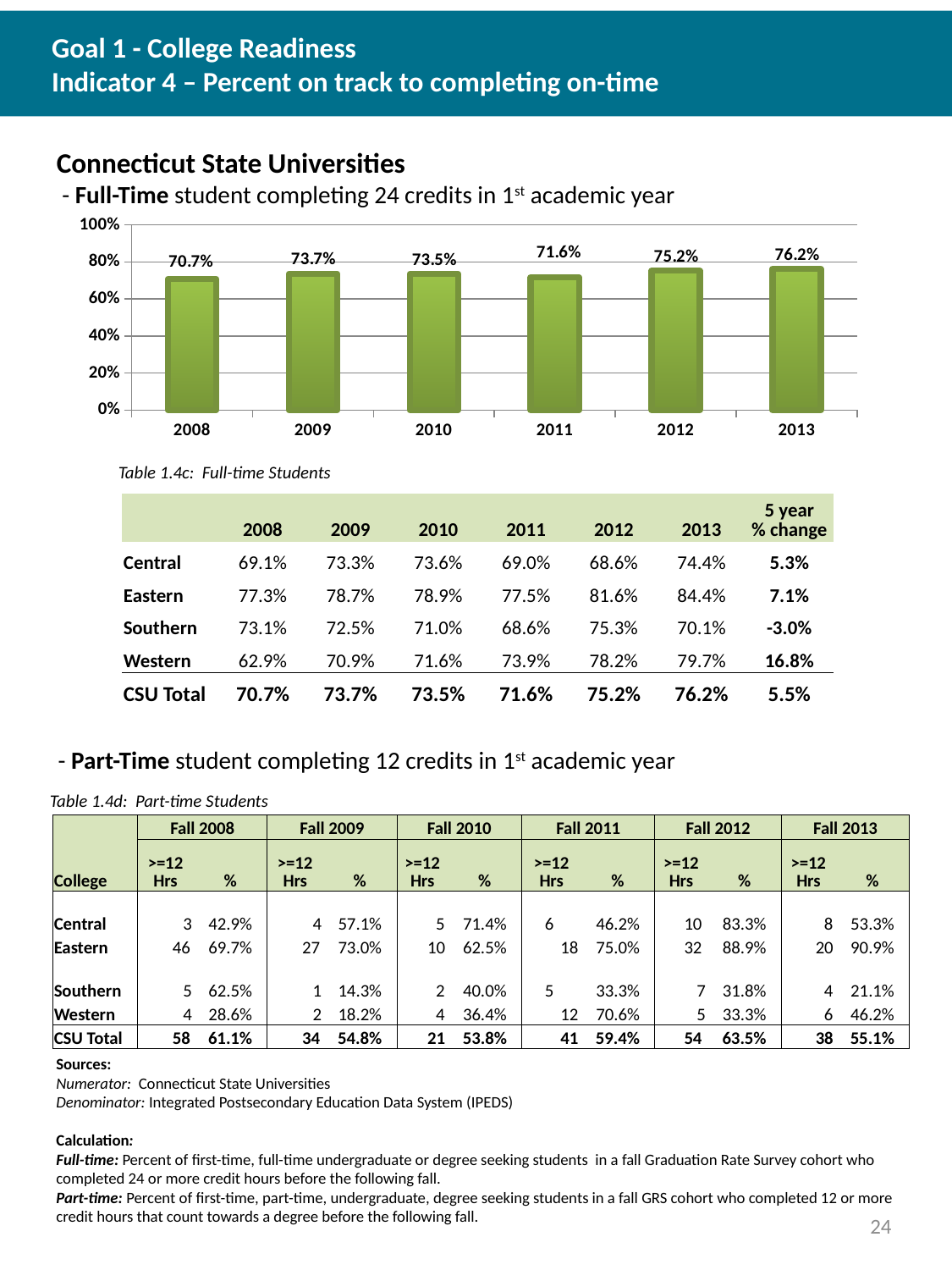
How many years are shown on the x axis of the bar chart? 6 What is the value for 2011 in the bar chart? 71.6% What is the difference between the values for 2013 and 2008 in the bar chart? 5.5% Which year has the lowest value in the bar chart? 2008 In the bar chart, which is larger, the value for 2009 or the value for 2010? 2009 What is the value for 2008 in the bar chart? 70.7% What is the highest value shown on the y axis of the bar chart? 100% What is the difference between the values for 2012 and 2011 in the bar chart? 3.6% What is the value for 2013 in the bar chart? 76.2% Is the value for 2012 in the bar chart greater or less than 60%? greater Which year has the highest value in the bar chart? 2013 What kind of chart is shown on the slide? bar chart